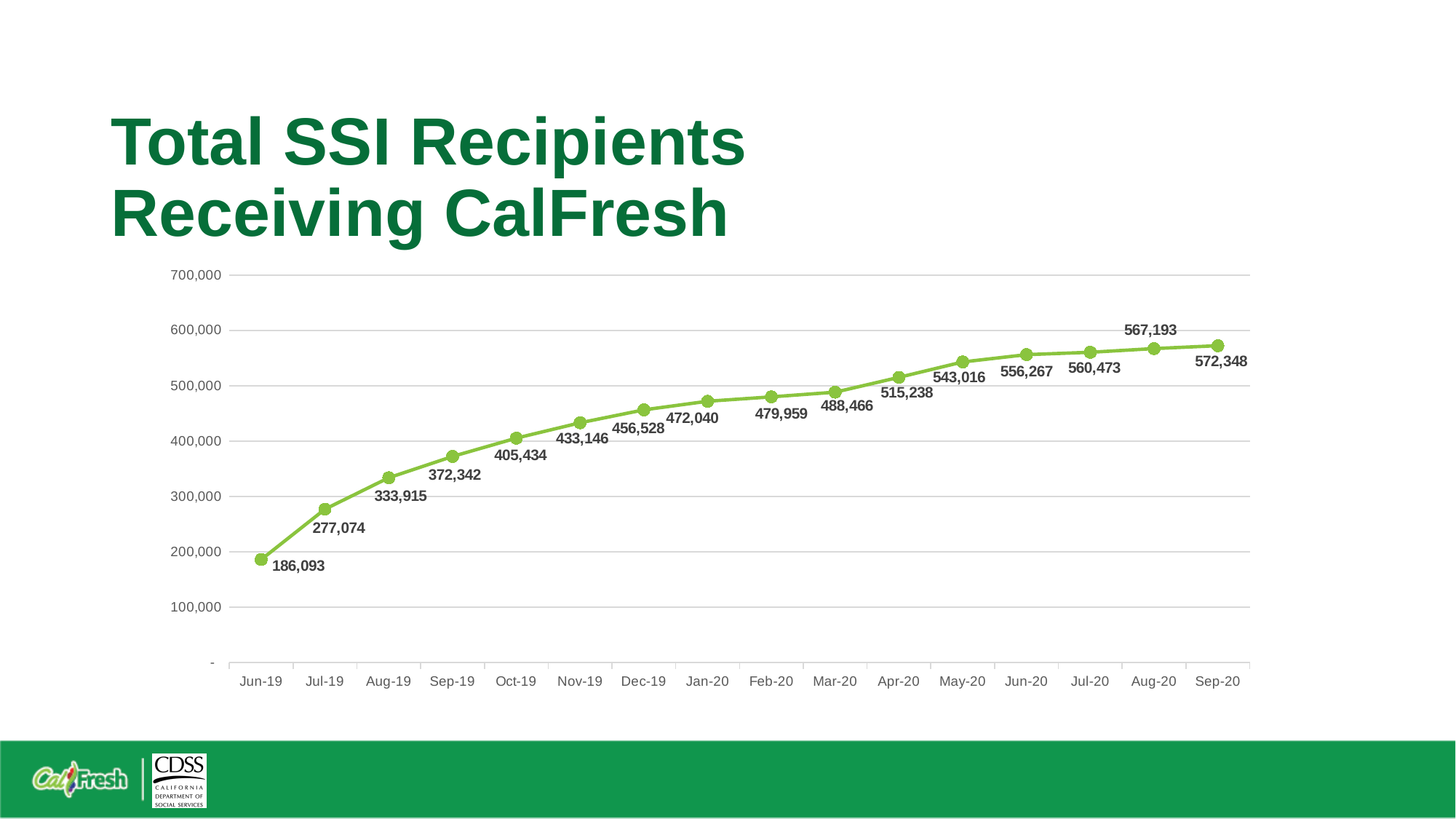
What is the value for Mar-20? 488,466 Which month has the lowest value? Jun-19 Which is larger, the value for Dec-19 or the value for Nov-19? Dec-19 Do the values rise or fall from Jun-19 to Sep-20? rise What is the value for Sep-20? 572,348 What is the difference between the values for Jul-19 and Jun-19? 90,981 How many data points are plotted on the chart? 16 What is the value for Jun-19? 186,093 What is the difference between the values for Sep-20 and Jun-19? 386,255 Which month has the highest value? Sep-20 Is the value for Oct-19 greater or less than 400,000? greater What kind of chart is shown on the slide? line chart